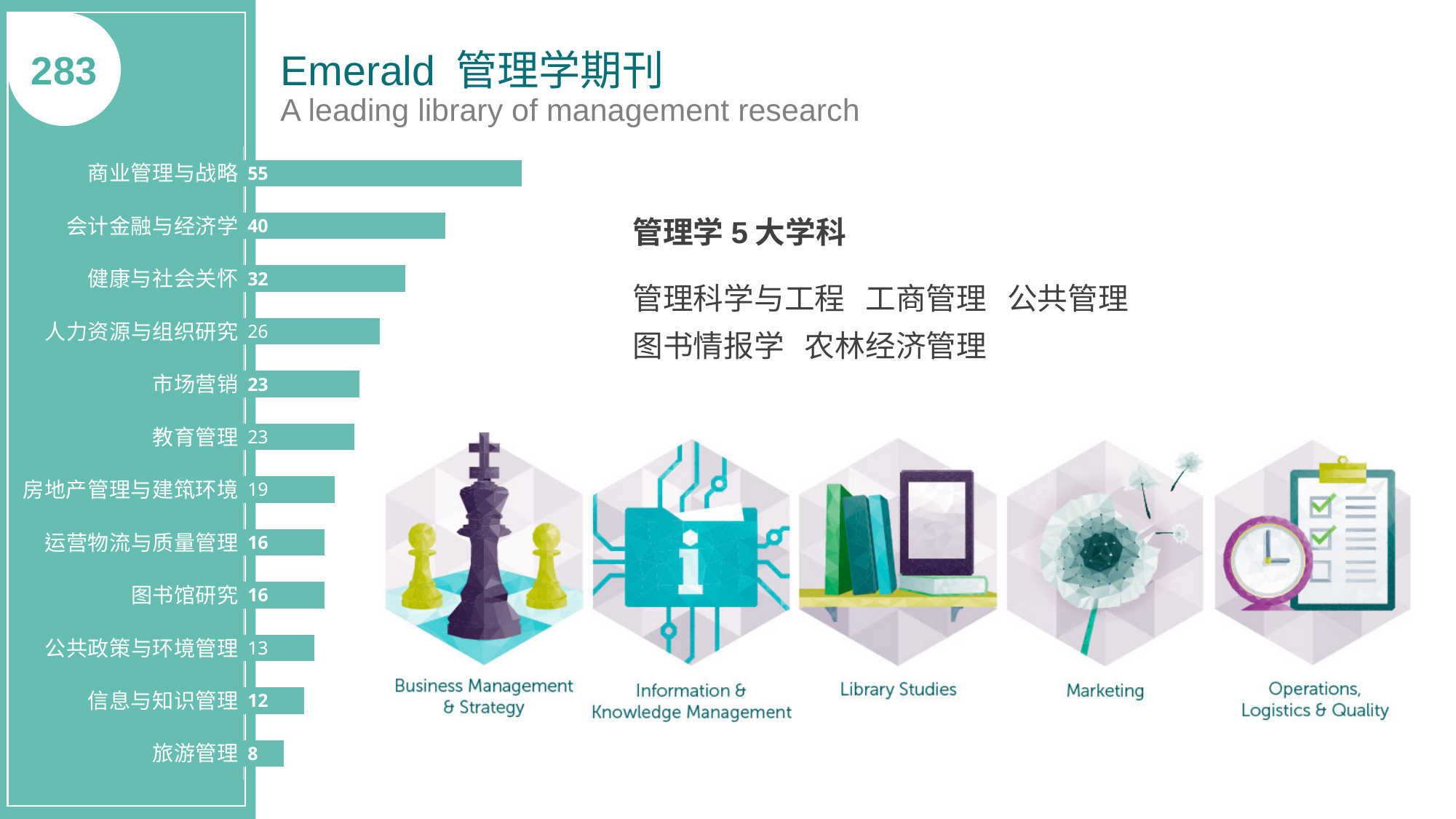
What is the difference between the values for 公共政策与环境管理 and 信息与知识管理? 1 What is the value for 商业管理与战略? 55 What is the value for 会计金融与经济学? 40 What is the value for 旅游管理? 8 What is the value for 房地产管理与建筑环境? 19 Which is larger, the value for 健康与社会关怀 or the value for 人力资源与组织研究? 健康与社会关怀 Which category has the highest value? 商业管理与战略 What kind of chart is shown on the left of the slide? bar chart What is the difference between the values for 商业管理与战略 and 会计金融与经济学? 15 Do the values rise or fall going down the bar chart from top to bottom? fall How many categories does the bar chart show? 12 Which category has the lowest value? 旅游管理